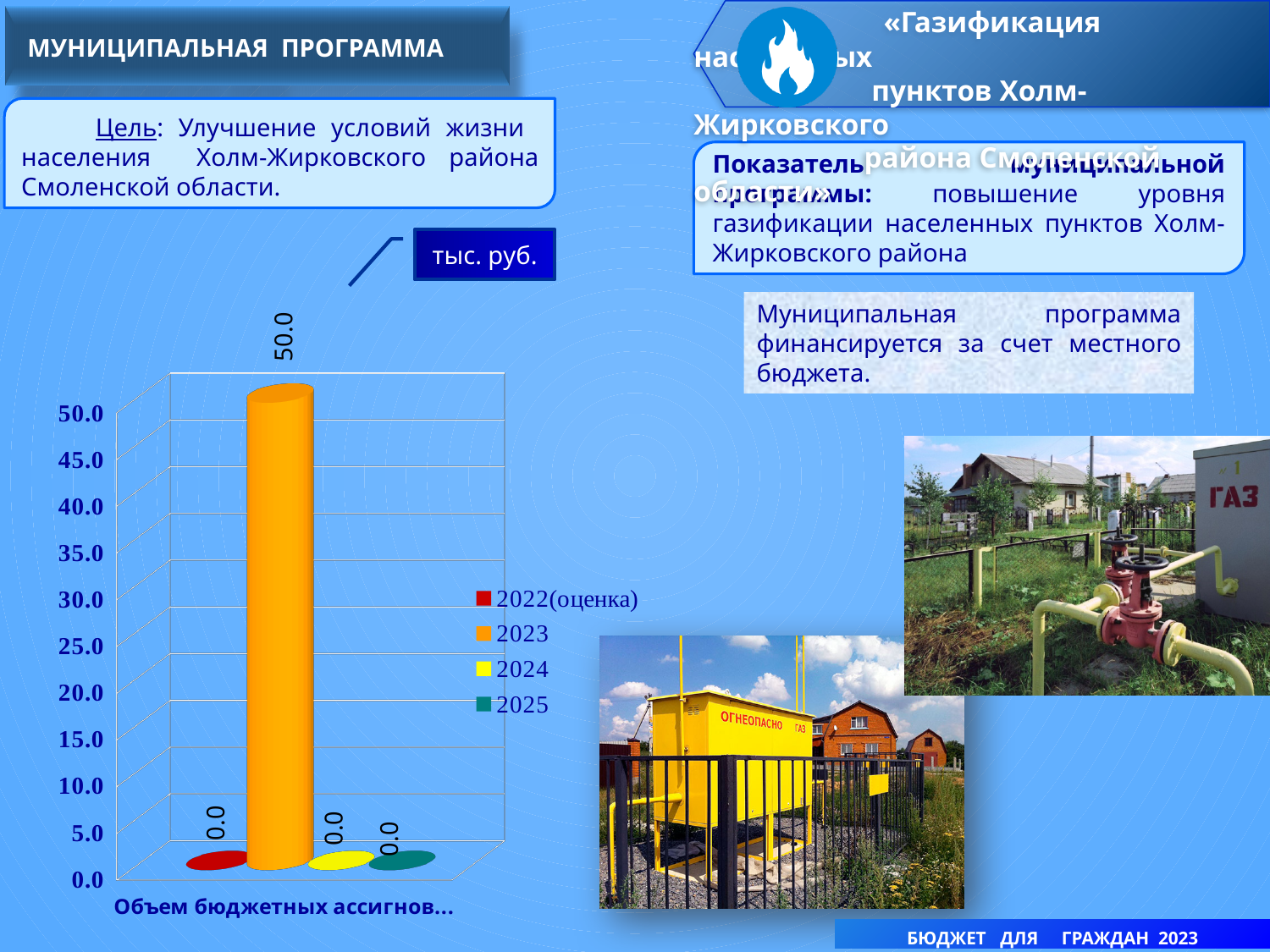
Is the value for 2023 greater or less than 45.0? greater Which series has the highest value in the chart? 2023 How many series does the legend list? 4 What kind of chart is shown on the slide? bar chart What is the difference between the 2023 value and the 2024 value? 50.0 Which is larger, the value for 2023 or the value for 2025? 2023 What colour is the bar for the 2023 series? orange What is the value for the 2023 series in the chart? 50.0 What unit is shown in the label above the chart? тыс. руб. What is the value for the 2022(оценка) series in the chart? 0.0 What is the value for the 2025 series in the chart? 0.0 What is the value for the 2024 series in the chart? 0.0